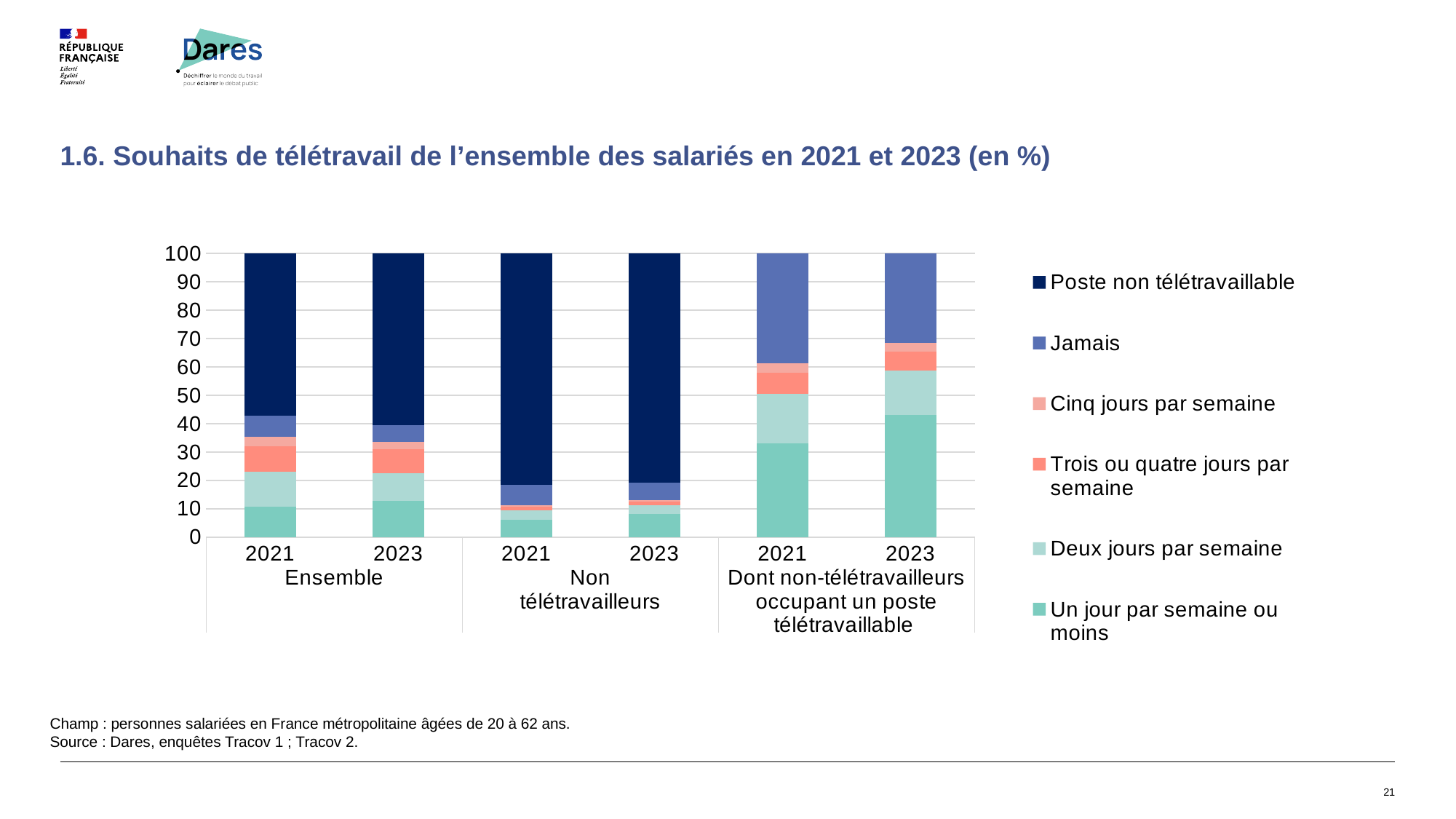
Is the 'Poste non télétravaillable' segment for 2021 in the 'Non télétravailleurs' group greater or less than 70? greater Is the 'Un jour par semaine ou moins' segment for 2021 in the group 'Dont non-télétravailleurs occupant un poste télétravaillable' greater or less than 30? greater What is the title of the chart on the slide? 1.6. Souhaits de télétravail de l'ensemble des salariés en 2021 et 2023 (en %) What kind of chart is shown on the slide? Stacked bar chart How many stacked bars are plotted in the chart? 6 In the group 'Dont non-télétravailleurs occupant un poste télétravaillable', which year has the larger 'Jamais' segment, 2021 or 2023? 2021 How many series does the legend list? 6 Is the value of 'Un jour par semaine ou moins' for 2021 in the 'Ensemble' group greater or less than 20? less For 2021, which group has the larger 'Poste non télétravaillable' segment, 'Ensemble' or 'Non télétravailleurs'? Non télétravailleurs Which legend entry is listed first (at the top of the legend)? Poste non télétravaillable In the group 'Dont non-télétravailleurs occupant un poste télétravaillable', which year has the larger 'Un jour par semaine ou moins' segment, 2021 or 2023? 2023